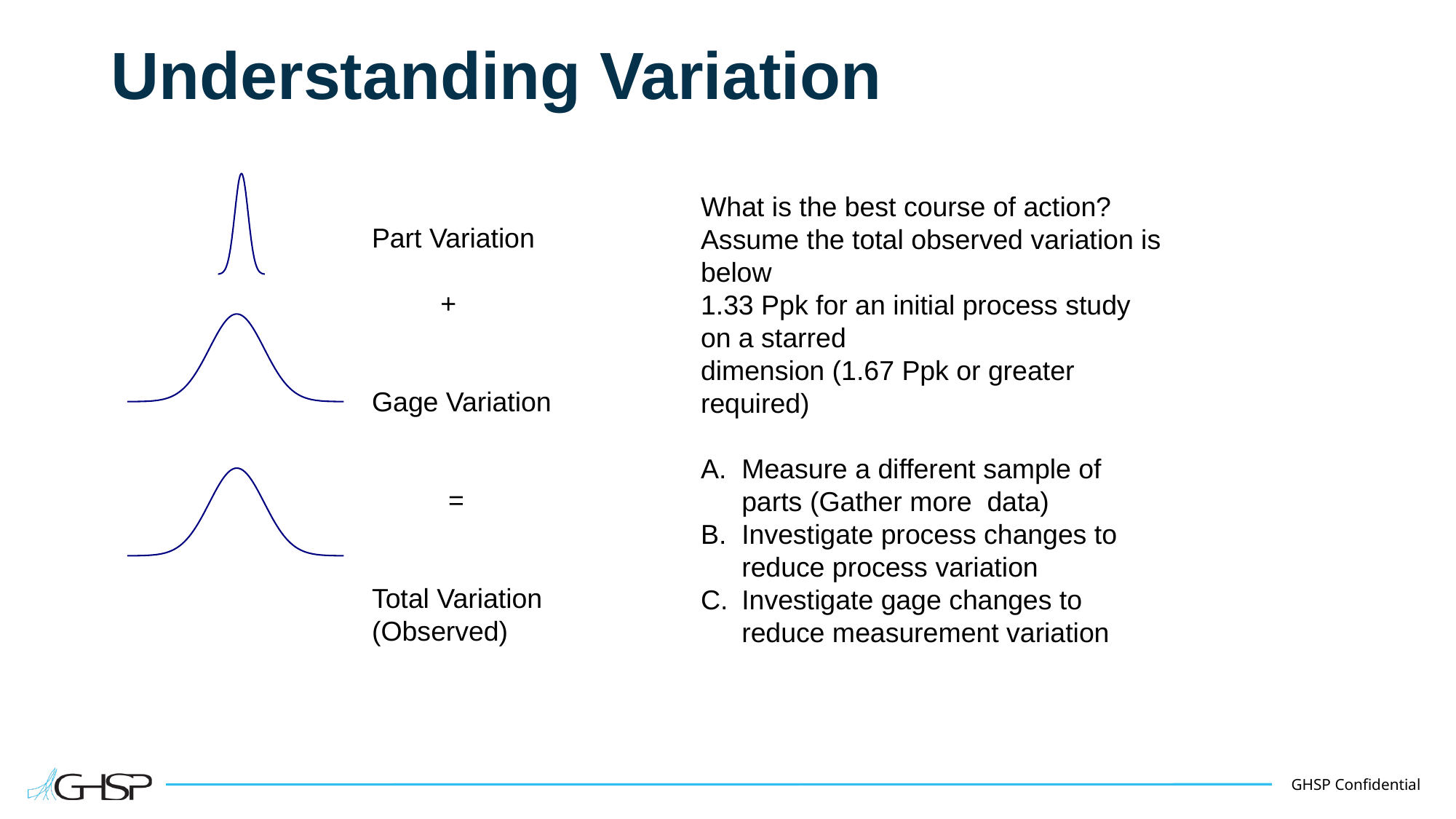
What label is given to the top (narrowest) curve on the slide? Part Variation What kind of graphic is used to represent each type of variation on the slide? bell-shaped distribution curve What label is given to the bottom curve on the slide? Total Variation (Observed) How many distribution curves are drawn on the slide? 3 Which of the three curves is the narrowest and tallest? Part Variation Is the Part Variation curve narrower or wider than the Gage Variation curve? narrower